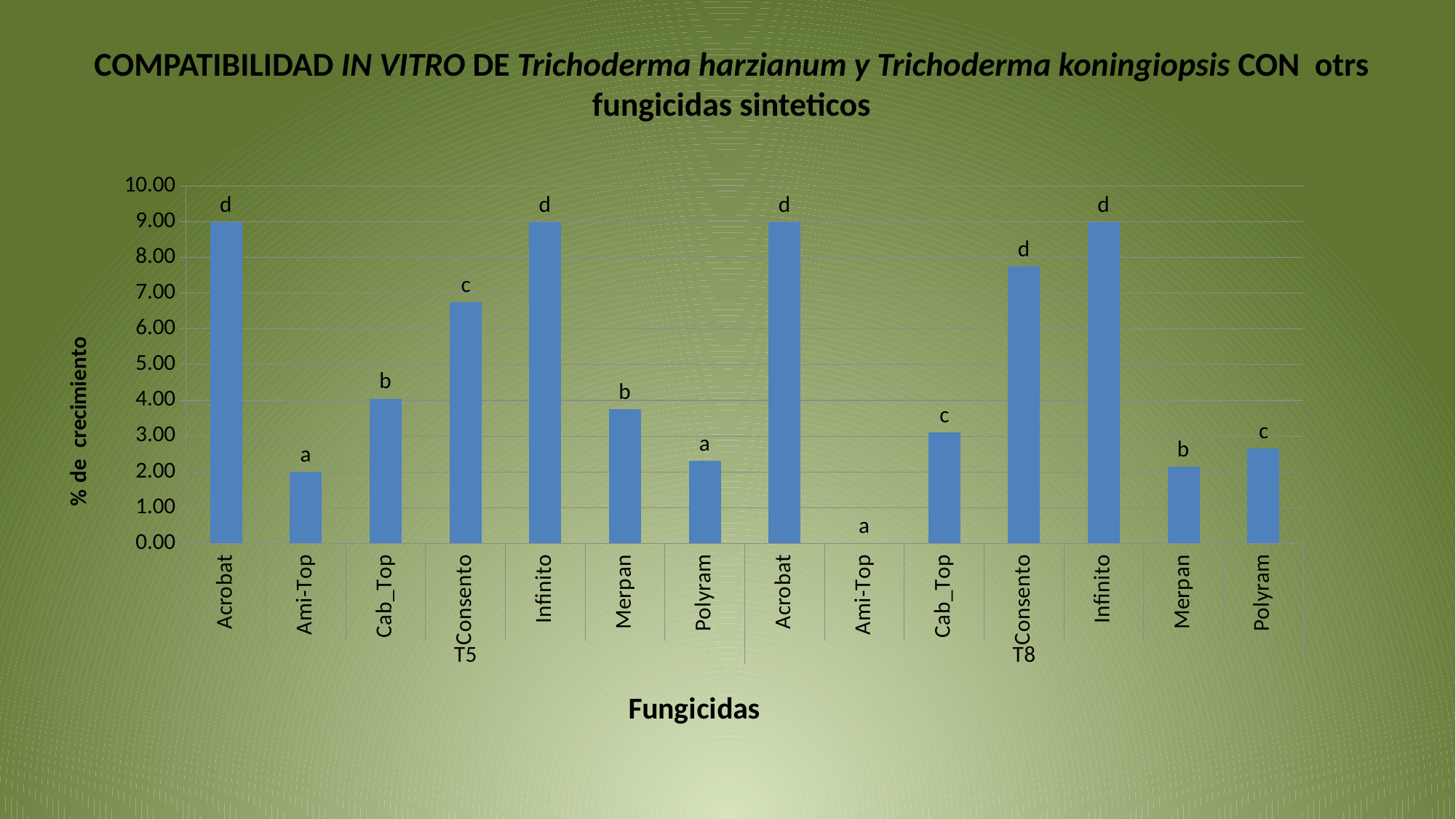
Is the value for Merpan in the T5 group greater or less than 4.00? less What is the value for Ami-Top in the T8 group? 0.00 What kind of chart is shown on the slide? bar chart What is the value for Infinito in the T8 group? 9.00 What is the title of the y axis? % de crecimiento How many fungicides are listed on the x axis within the T5 group? 7 Is the value for TConsento in the T5 group greater or less than 6.00? greater Is the value for TConsento in the T8 group greater or less than 7.00? greater Which fungicide has the lowest value in the T8 group? Ami-Top Which is larger: the value for TConsento in the T5 group or in the T8 group? T8 What is the value for Acrobat in the T5 group? 9.00